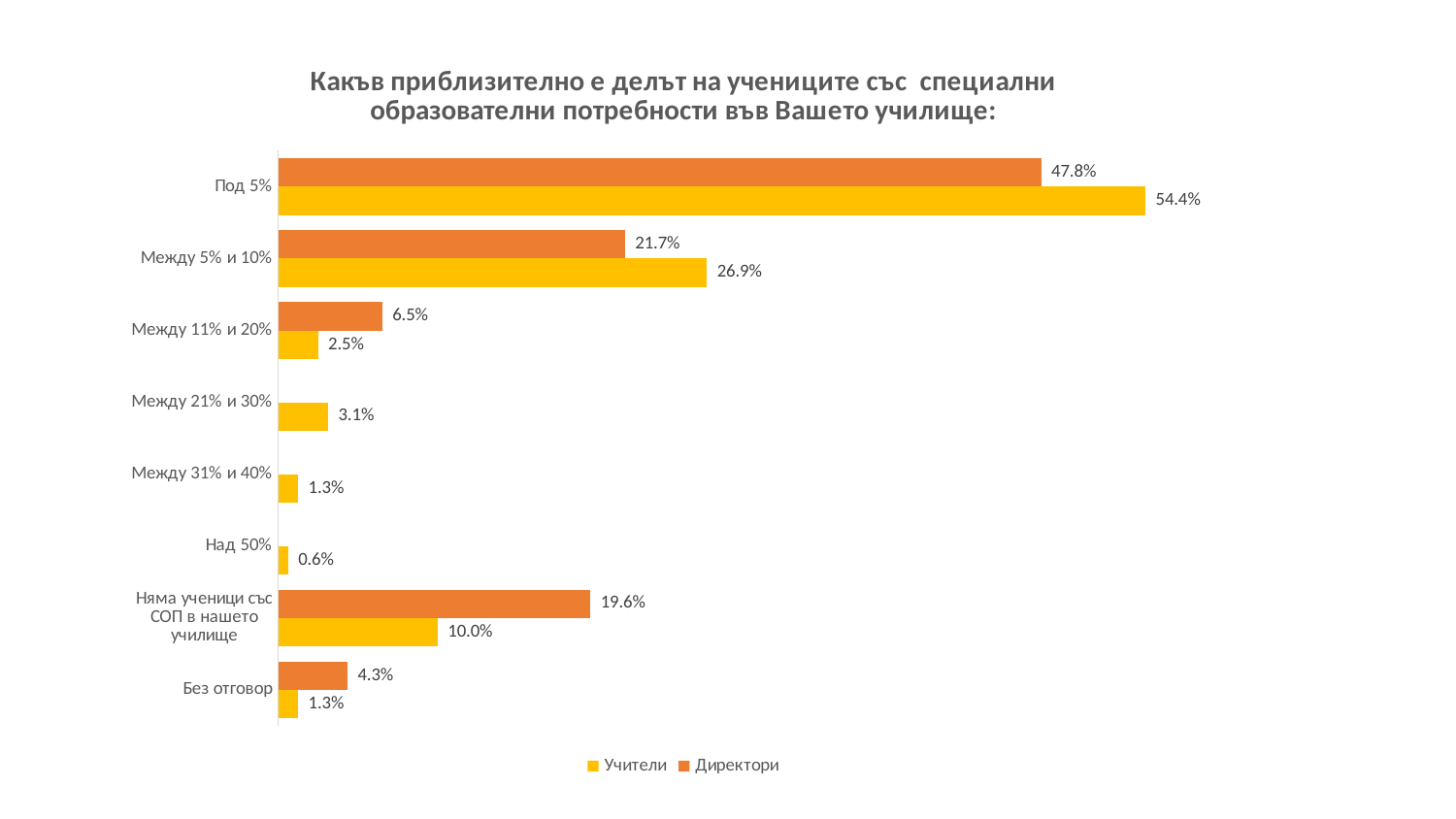
What is the value for Учители in the category Под 5%? 54.4% How many categories are shown on the chart? 8 What is the value for Директори in the category Под 5%? 47.8% Which category has the lowest value for Учители? Над 50% What is the difference between Учители and Директори in the category Под 5%? 6.6% Which series is shown in orange in the legend? Директори In the category Между 11% и 20%, which series has the larger value, Учители or Директори? Директори How many series does the legend list? 2 Which category has the highest value for Учители? Под 5% What type of chart is shown on the slide? bar chart What is the value for Директори in the category Няма ученици със СОП в нашето училище? 19.6% What is the value for Учители in the category Между 5% и 10%? 26.9%